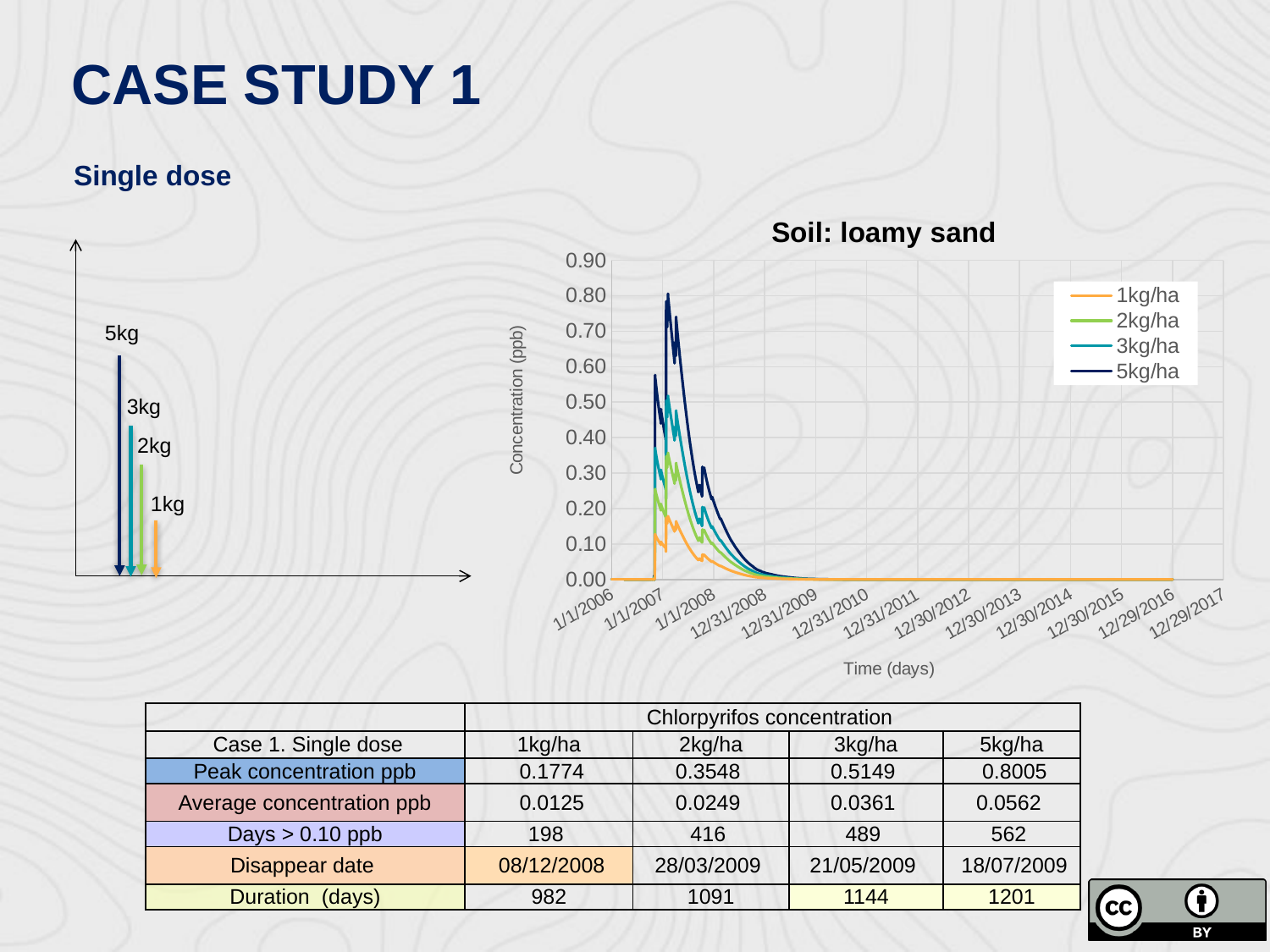
What is the label of the y axis in the "Soil: loamy sand" chart? Concentration (ppb) What kind of chart is shown under the title "Soil: loamy sand"? line chart What is the highest tick value shown on the y axis of the "Soil: loamy sand" chart? 0.90 In the "Soil: loamy sand" chart, do the concentration values rise or fall along the x axis after their peak in 2007? fall How many series does the legend of the "Soil: loamy sand" chart list? 4 In the "Soil: loamy sand" chart, is the peak value of the 1kg/ha series greater or less than 0.20? less In the "Soil: loamy sand" chart, is the peak value of the 3kg/ha series greater or less than 0.60? less In the "Soil: loamy sand" chart, which series peaks higher, 3kg/ha or 2kg/ha? 3kg/ha In the "Soil: loamy sand" chart, is the peak value of the 5kg/ha series greater or less than 0.70? greater In the "Soil: loamy sand" chart, which series has the lowest peak concentration? 1kg/ha In the "Soil: loamy sand" chart, which series reaches the highest peak concentration? 5kg/ha